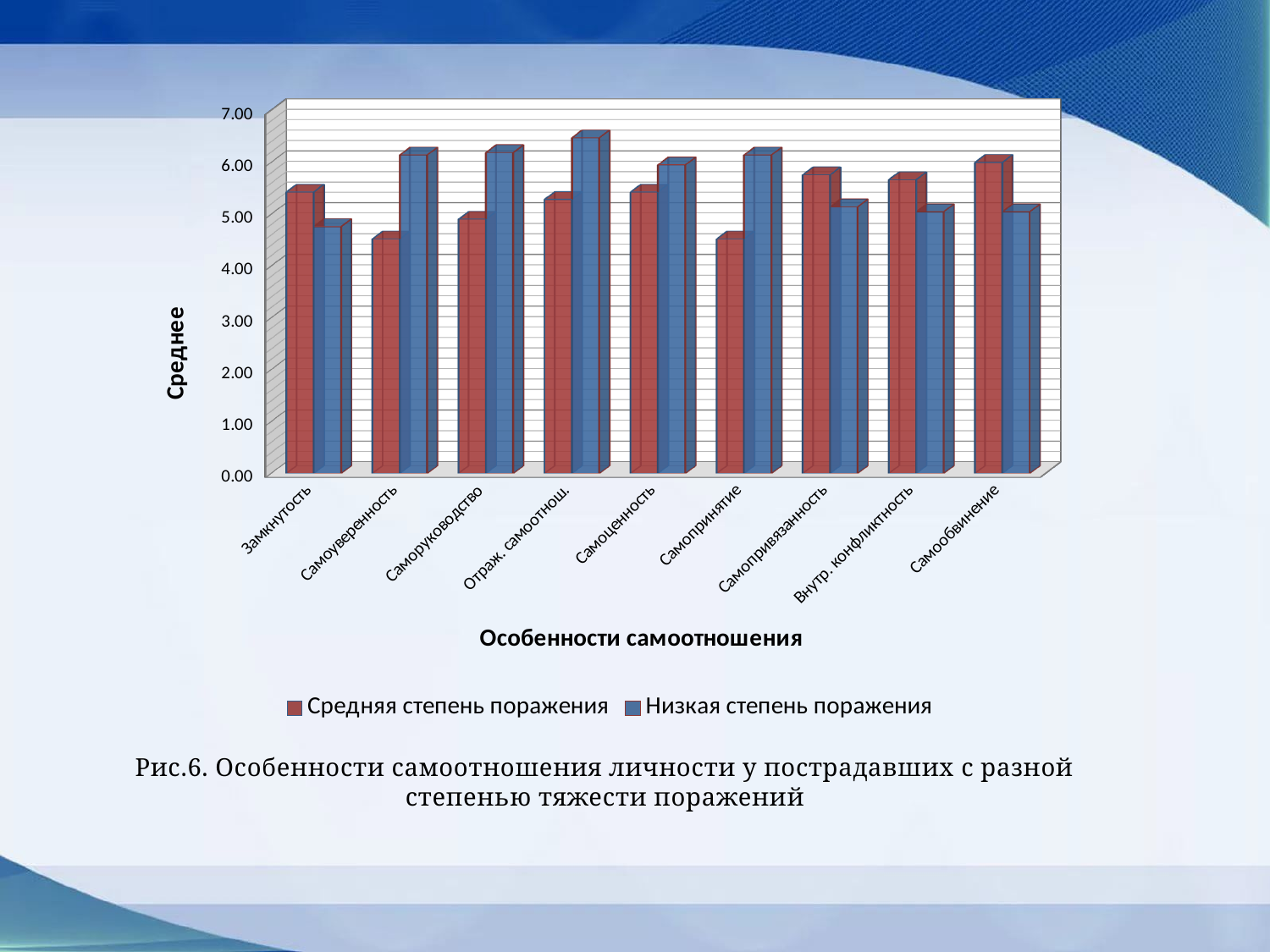
What is the title of the vertical axis? Среднее Which series is shown in blue according to the legend? Низкая степень поражения How many categories are shown on the x axis? 9 Is the value for Отраж. самоотнош. in the Низкая степень поражения series greater or less than 6.00? greater How many series does the legend list? 2 Which category has the highest value in the Низкая степень поражения series? Отраж. самоотнош. Is the value for Самопринятие in the Средняя степень поражения series greater or less than 5.00? less For Самообвинение, which series has the larger value: Средняя степень поражения or Низкая степень поражения? Средняя степень поражения What kind of chart is shown on the slide? Bar chart Is the value for Самоуверенность in the Средняя степень поражения series greater or less than 5.00? less For Самоуверенность, which series has the larger value: Средняя степень поражения or Низкая степень поражения? Низкая степень поражения